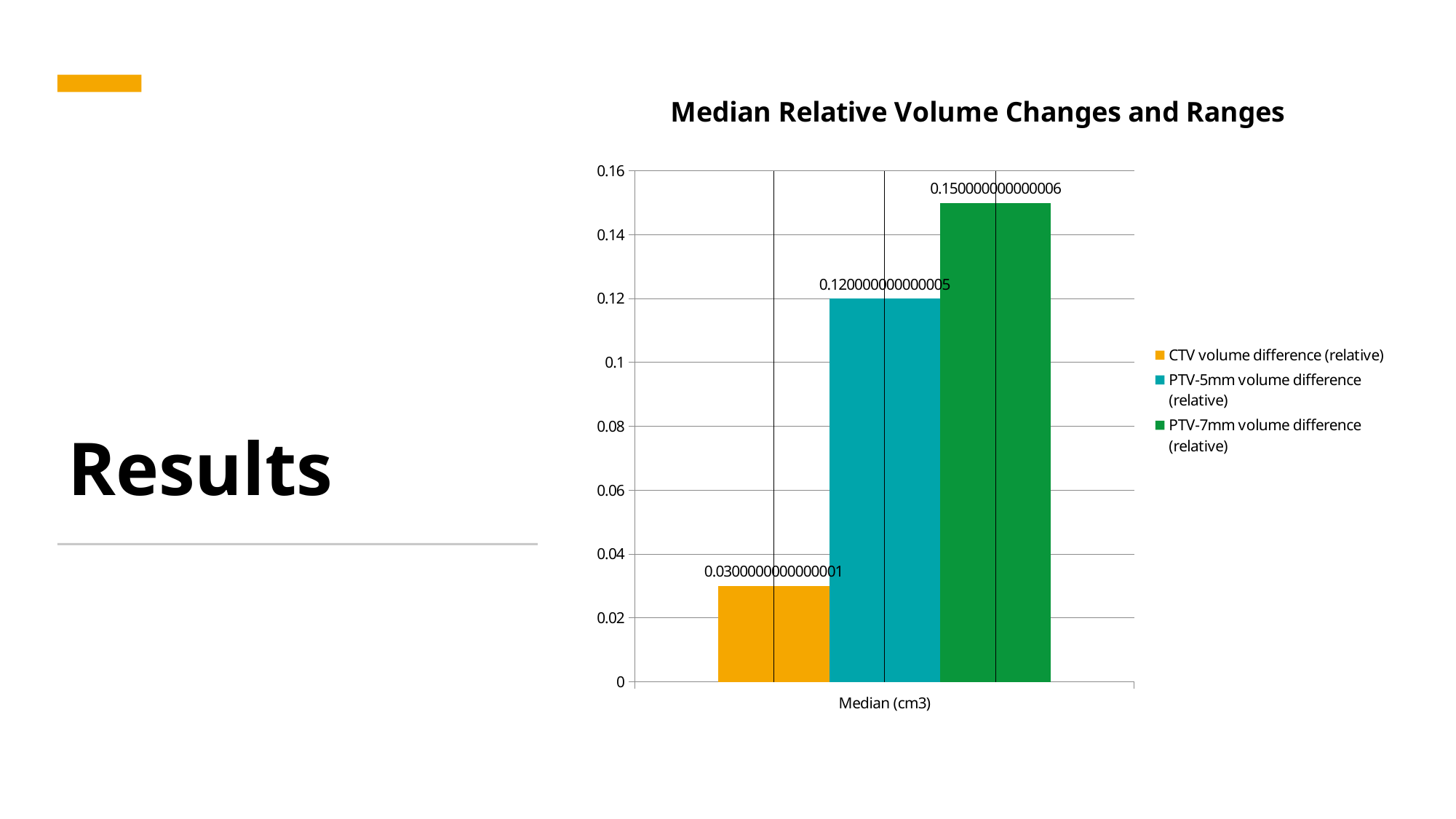
Is the value for CTV volume difference (relative) greater or less than 0.04? less Is the value for PTV-7mm volume difference (relative) greater or less than 0.14? greater What is the title of the chart? Median Relative Volume Changes and Ranges What is the label on the x axis category? Median (cm3) Which is larger, the PTV-5mm volume difference (relative) or the CTV volume difference (relative)? PTV-5mm volume difference (relative) How many series does the legend list? 3 Which series has the lowest value? CTV volume difference (relative) What is the value of the CTV volume difference (relative) bar? 0.0300000000000001 Which series has the highest value? PTV-7mm volume difference (relative) What is the value of the PTV-7mm volume difference (relative) bar? 0.150000000000006 What is the value of the PTV-5mm volume difference (relative) bar? 0.120000000000005 What type of chart is shown on the slide? bar chart